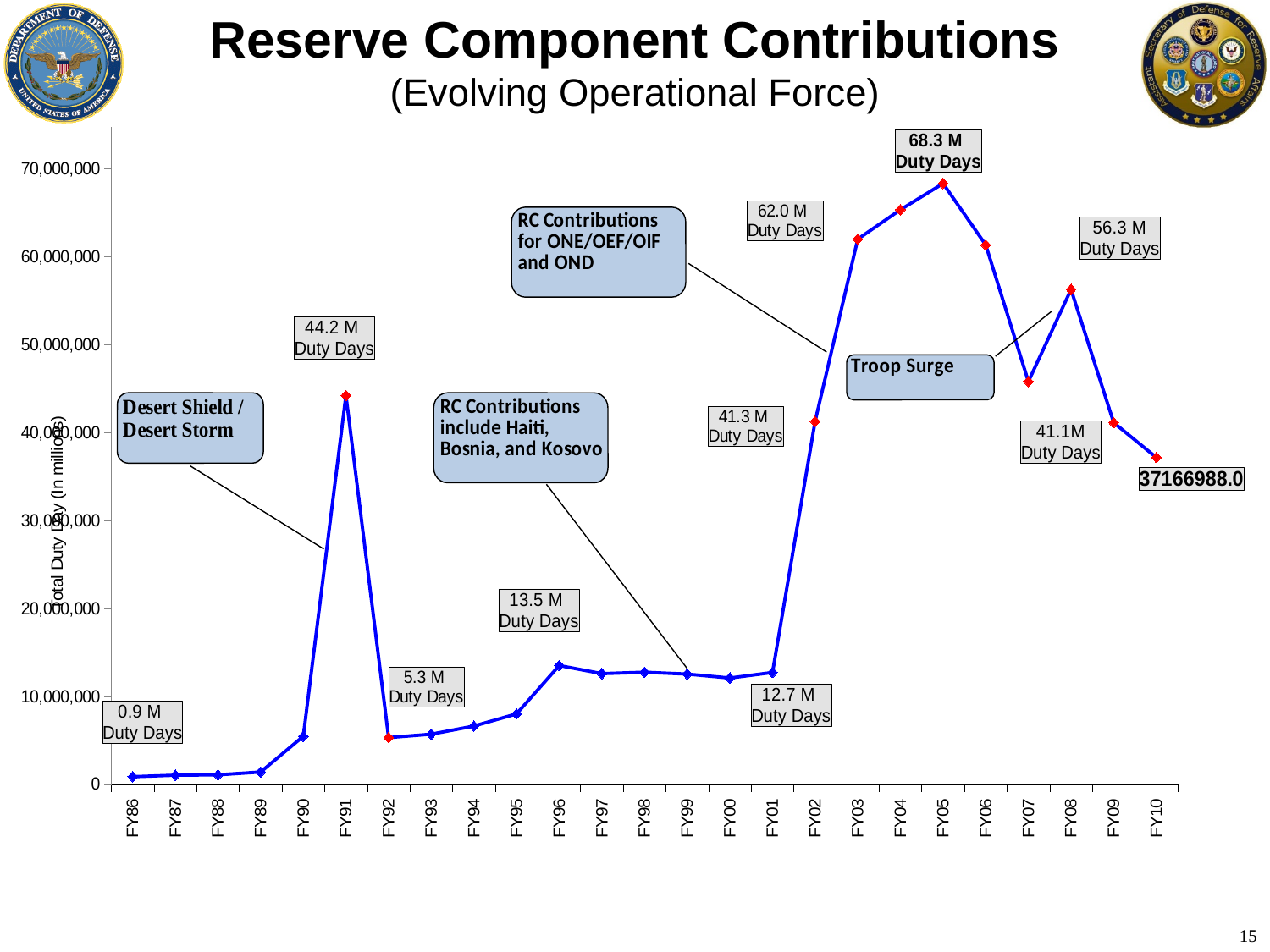
What is the labeled value for FY91? 44.2 M Duty Days Which is larger, the value for FY91 or the value for FY03? FY03 How many fiscal years are plotted on the x axis? 25 What is the labeled value for FY05? 68.3 M Duty Days What is the labeled value for FY10? 37166988.0 Do the values rise or fall from FY05 to FY07? fall Is the value for FY07 greater or less than 50,000,000? less What is the labeled value for FY86? 0.9 M Duty Days What kind of chart is shown on the slide? line chart What is the difference between the labeled values for FY91 and FY92? 38.9 M Duty Days What is the difference between the labeled values for FY05 and FY08? 12.0 M Duty Days Which fiscal year has the highest total duty days? FY05